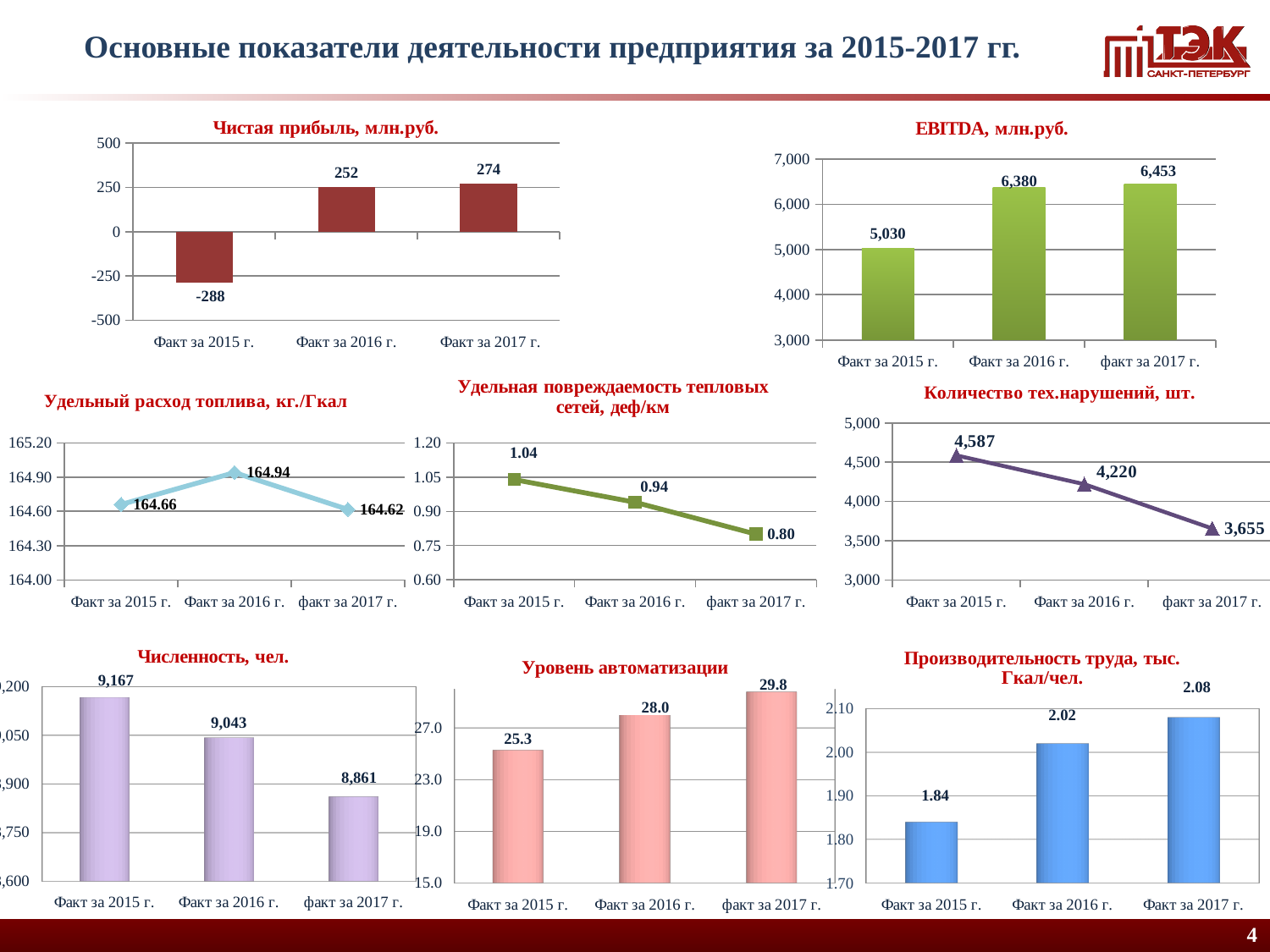
In the 'Уровень автоматизации' chart, which is larger: the value for Факт за 2016 г. or Факт за 2015 г.? Факт за 2016 г. In the 'Количество тех.нарушений, шт.' chart, which category has the lowest value? факт за 2017 г. In the 'Удельная повреждаемость тепловых сетей, деф/км' chart, do the values rise or fall from 2015 to 2017? fall In the 'Чистая прибыль, млн.руб.' chart, what is the value for Факт за 2015 г.? -288 How many charts are shown on the slide? 8 In the 'Удельный расход топлива, кг./Гкал' chart, what is the value for Факт за 2016 г.? 164.94 In the 'Численность, чел.' chart, what is the difference between the values for Факт за 2015 г. and факт за 2017 г.? 306 In the 'Количество тех.нарушений, шт.' chart, what is the value for факт за 2017 г.? 3,655 What kind of chart is the 'Удельный расход топлива, кг./Гкал' chart? line chart In the 'Производительность труда, тыс. Гкал/чел.' chart, what is the value for Факт за 2015 г.? 1.84 In the 'EBITDA, млн.руб.' chart, which category has the highest value? факт за 2017 г. In the 'EBITDA, млн.руб.' chart, what is the difference between the values for Факт за 2016 г. and Факт за 2015 г.? 1,350